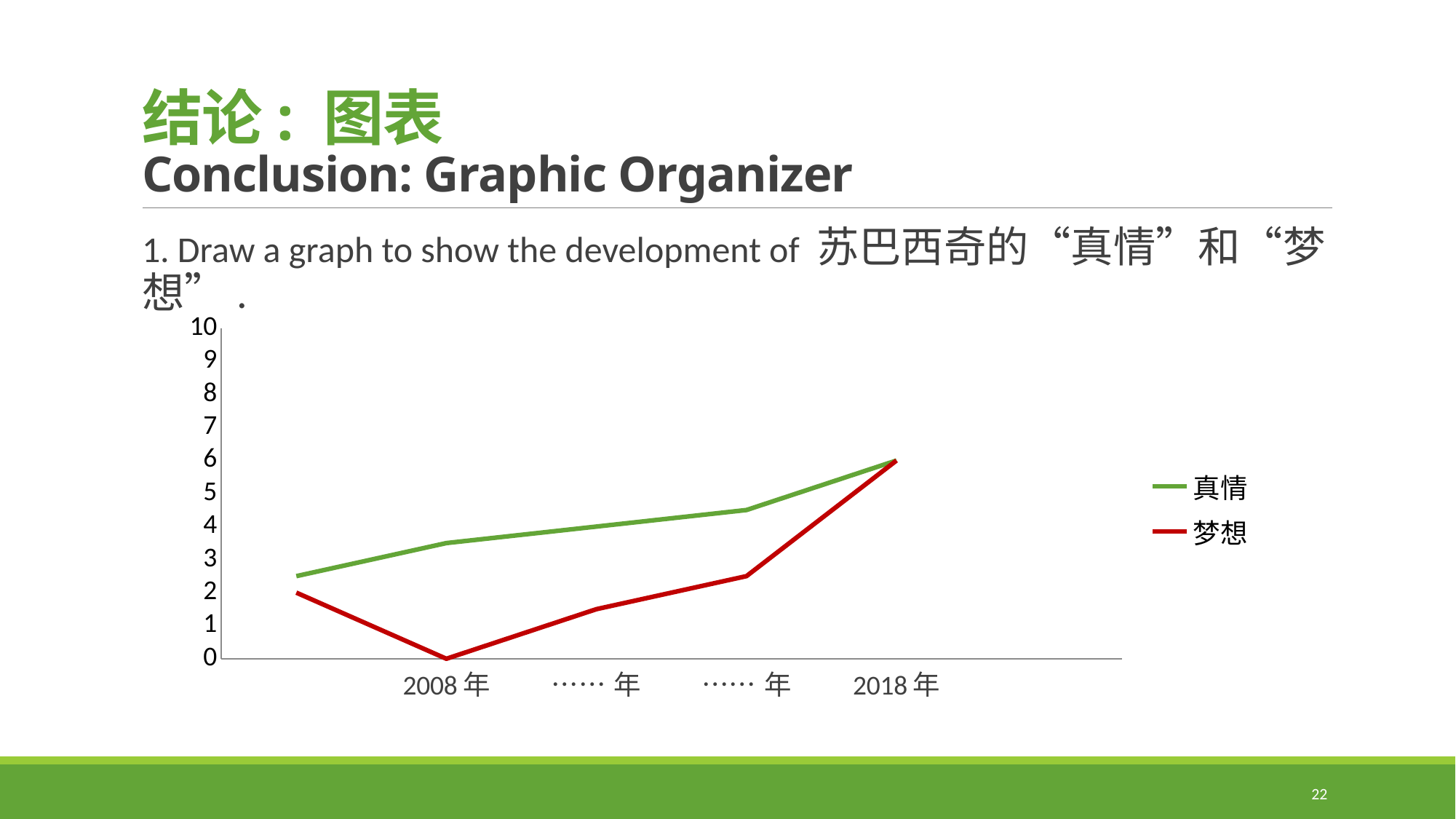
What is the value of 梦想 at 2008 年? 0 What kind of chart is shown on the slide? line chart Does the 真情 line rise or fall from left to right along the x axis? rise At which labelled year does 真情 reach its highest value? 2018 年 Is the value of 真情 at 2008 年 greater or less than 3? greater What is the value of 真情 at 2018 年? 6 How many series does the chart's legend list? 2 What is the value of 梦想 at 2018 年? 6 At 2008 年, which series has the higher value, 真情 or 梦想? 真情 Which colour is the 梦想 line drawn in? red At which labelled year does 梦想 reach its lowest value? 2008 年 What are the two series named in the legend? 真情 and 梦想